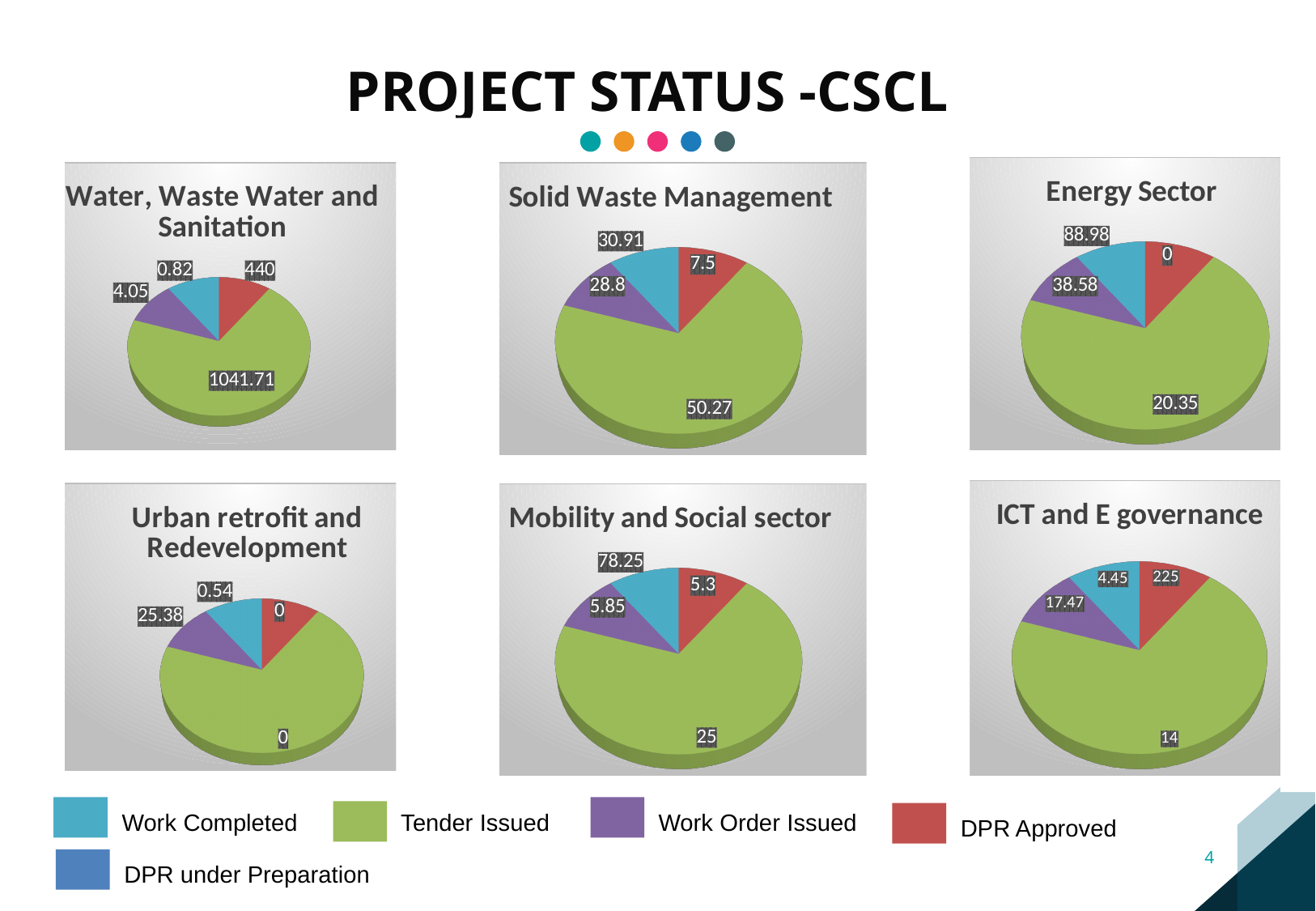
In the Solid Waste Management chart, what is the value labelled on the Work Completed slice? 30.91 How many entries does the legend at the bottom of the slide list? 5 In the Water, Waste Water and Sanitation chart, what is the value labelled on the Tender Issued slice? 1041.71 What kind of charts are shown on the slide? Pie charts In the Energy Sector chart, what is the value labelled on the Work Order Issued slice? 38.58 How many pie charts are on the slide? 6 In the Mobility and Social sector chart, what is the value labelled on the Work Completed slice? 78.25 In the ICT and E governance chart, what is the value labelled on the DPR Approved slice? 225 In the Water, Waste Water and Sanitation chart, what is the value labelled on the DPR Approved slice? 440 In the Mobility and Social sector chart, which has the larger labelled value: Work Order Issued or DPR Approved? Work Order Issued According to the legend, what colour represents Tender Issued? Green In the Solid Waste Management chart, what is the difference between the Tender Issued value (50.27) and the Work Order Issued value (28.8)? 21.47